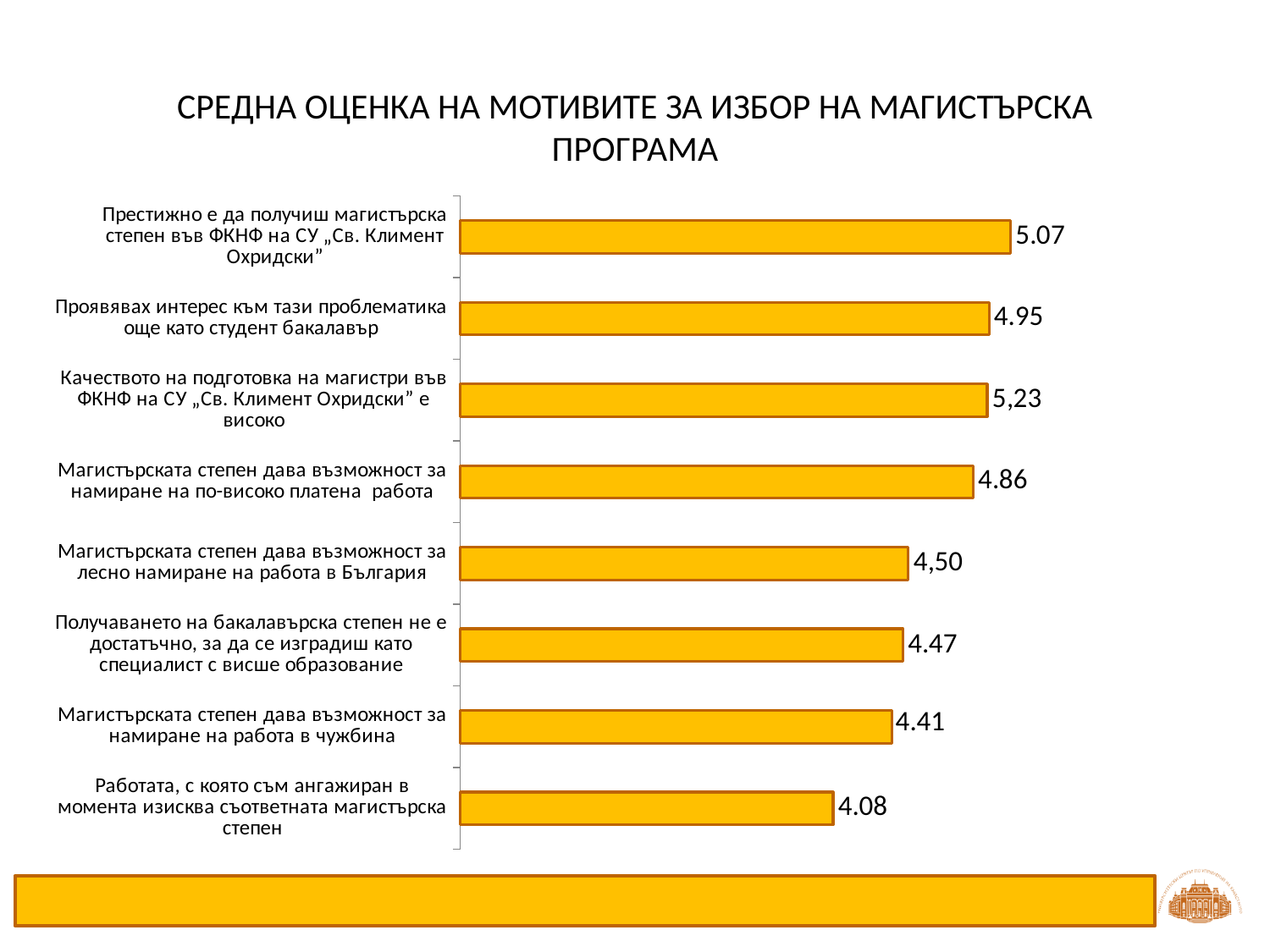
What is the average score for "Престижно е да получиш магистърска степен във ФКНФ на СУ „Св. Климент Охридски”"? 5.07 What is the average score for "Работата, с която съм ангажиран в момента изисква съответната магистърска степен"? 4.08 Which motive has the lowest average score? Работата, с която съм ангажиран в момента изисква съответната магистърска степен What colour are the bars in the chart? Orange What type of chart is shown on the slide? Bar chart What is the difference between the average score for "Магистърската степен дава възможност за намиране на по-високо платена работа" and "Магистърската степен дава възможност за намиране на работа в чужбина"? 0.45 What is the average score for "Проявявах интерес към тази проблематика още като студент бакалавър"? 4.95 Which motive has the highest average score? Престижно е да получиш магистърска степен във ФКНФ на СУ „Св. Климент Охридски” What is the title of the chart? СРЕДНА ОЦЕНКА НА МОТИВИТЕ ЗА ИЗБОР НА МАГИСТЪРСКА ПРОГРАМА Which has a higher average score: "Магистърската степен дава възможност за лесно намиране на работа в България" or "Получаването на бакалавърска степен не е достатъчно, за да се изградиш като специалист с висше образование"? Магистърската степен дава възможност за лесно намиране на работа в България What is the average score for "Качеството на подготовка на магистри във ФКНФ на СУ „Св. Климент Охридски” е високо"? 5,23 How many motives are shown in the chart? 8